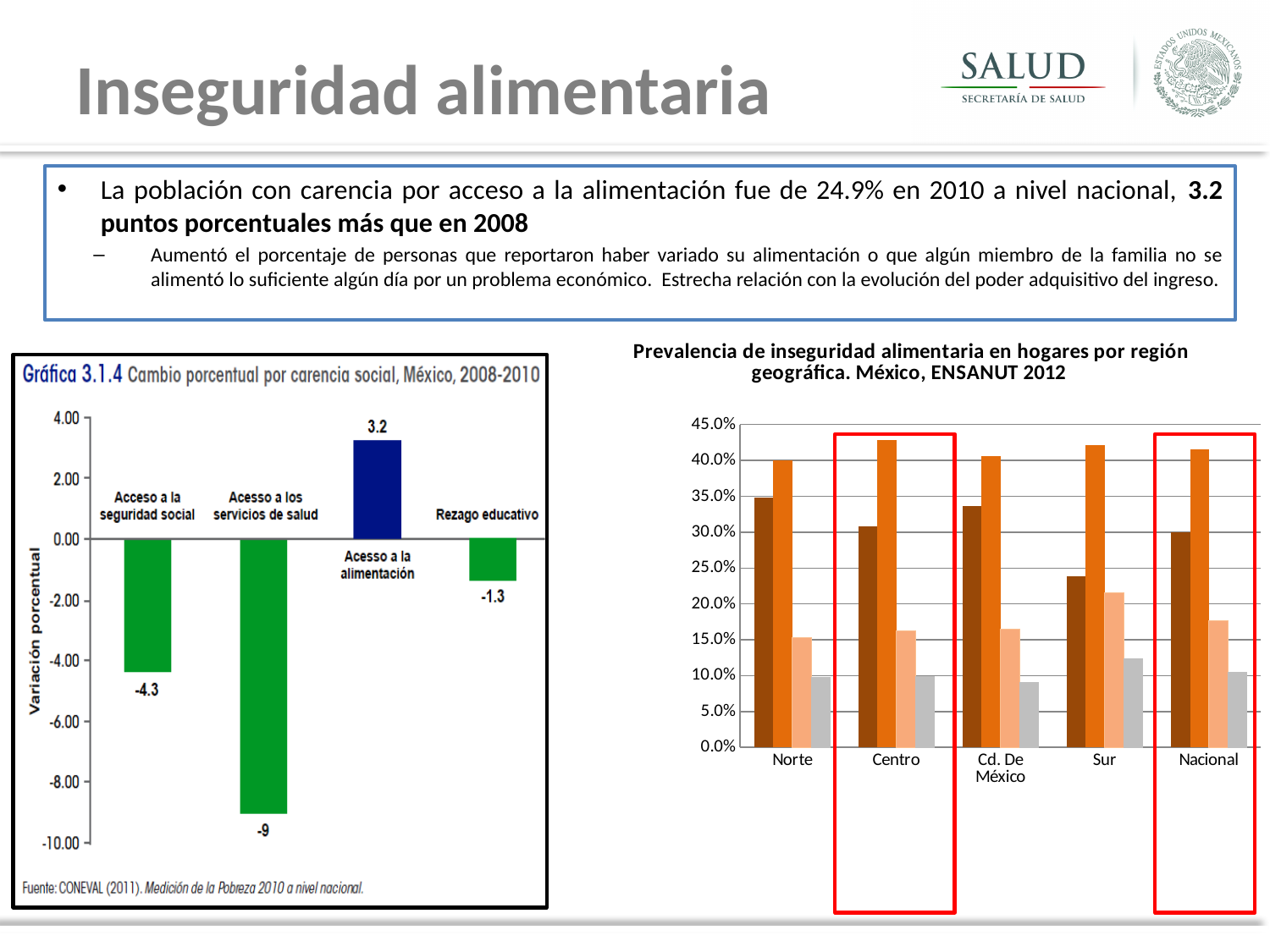
In the right chart (Prevalencia de inseguridad alimentaria), is the value of the second (orange) bar for Centro greater or less than 40.0%? greater In the right chart (Prevalencia de inseguridad alimentaria), is the value of the first (dark brown) bar for Sur greater or less than 25.0%? less In the right chart (Prevalencia de inseguridad alimentaria), how many regions are shown on the x axis? 5 In the left chart (Gráfica 3.1.4), which category has the highest value? Acceso a la alimentación What kind of chart is the left chart (Gráfica 3.1.4)? Bar chart In the left chart (Gráfica 3.1.4), which category has the lowest value? Acesso a los servicios de salud In the left chart (Gráfica 3.1.4), what is the difference between the values for Acceso a la alimentación and Rezago educativo? 4.5 In the left chart (Gráfica 3.1.4), what is the value for Acceso a la alimentación? 3.2 In the left chart (Gráfica 3.1.4), what is the value for Acceso a la seguridad social? -4.3 In the right chart (Prevalencia de inseguridad alimentaria), which regions are highlighted with red boxes? Centro and Nacional In the left chart (Gráfica 3.1.4), how many categories are plotted? 4 In the left chart (Gráfica 3.1.4), what is the value for Rezago educativo? -1.3